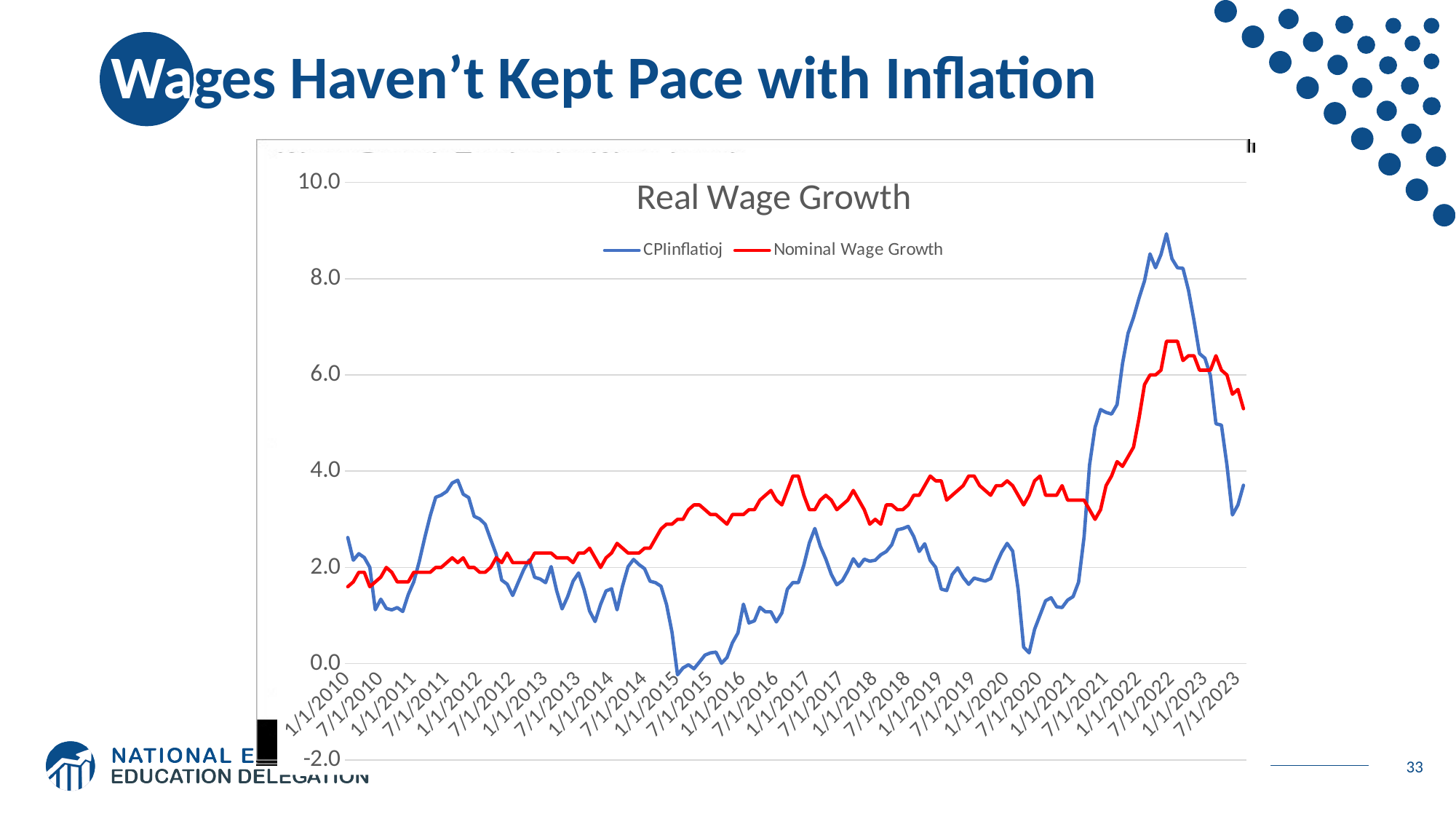
Does the CPIinflatioj line rise or fall between 1/1/2021 and 7/1/2022? rise Which colour is used for the Nominal Wage Growth line? red What kind of chart is shown on the slide? line chart Is the CPIinflatioj value at 7/1/2015 greater or less than 2.0? less How many series does the legend of the chart list? 2 At 7/1/2022, which series has the higher value, CPIinflatioj or Nominal Wage Growth? CPIinflatioj Which series reaches the highest value anywhere on the chart? CPIinflatioj Is the Nominal Wage Growth value at 1/1/2010 greater or less than 2.0? less At 1/1/2019, which series has the higher value, CPIinflatioj or Nominal Wage Growth? Nominal Wage Growth Is the peak value of the CPIinflatioj line around 7/1/2022 greater or less than 8.0? greater What is the title of the chart? Real Wage Growth